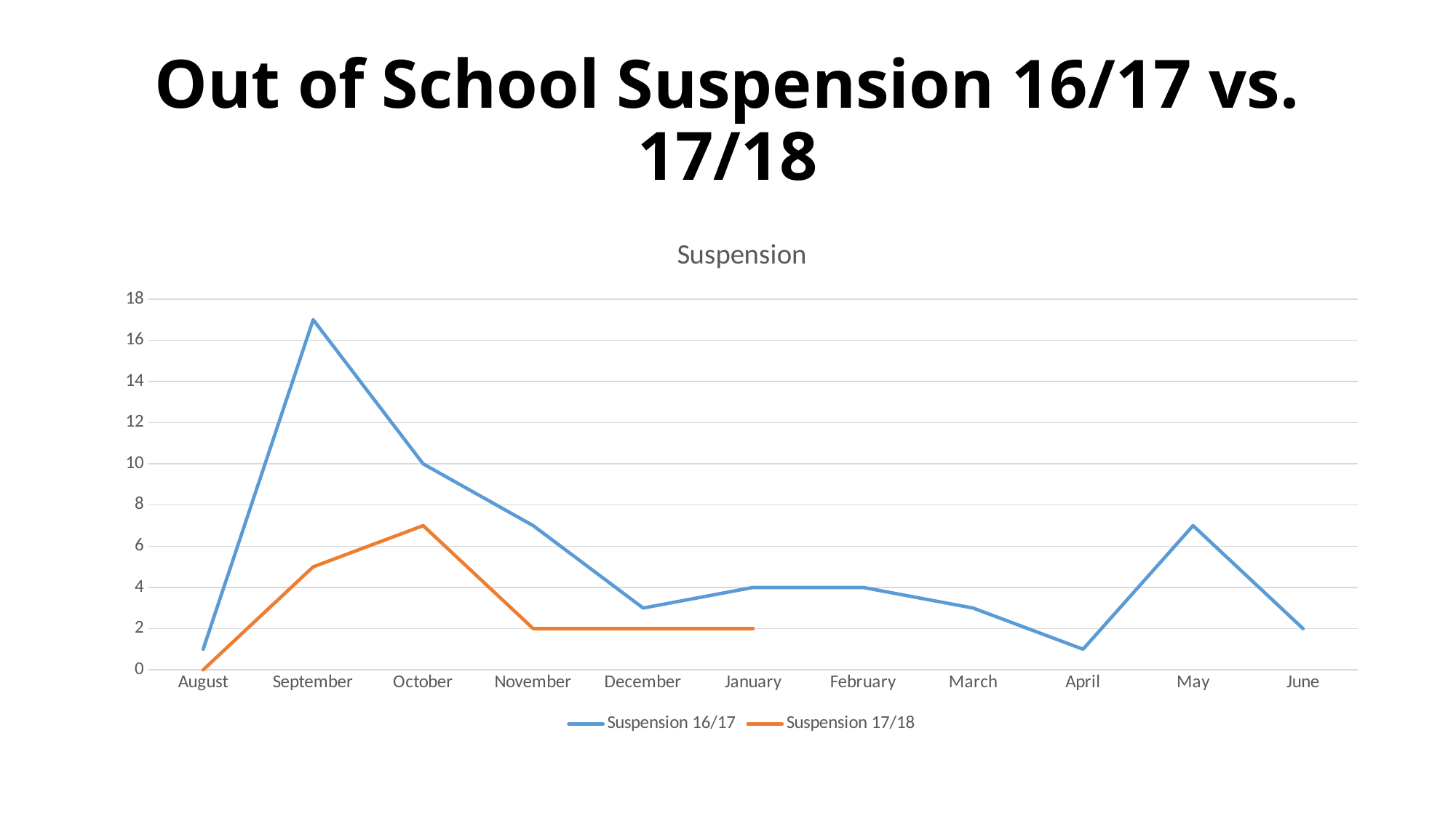
What is the value for Suspension 17/18 in August? 0 In which month is Suspension 17/18 highest? October Does Suspension 16/17 rise or fall from September to December? fall How many months are shown on the x axis? 11 Which is larger in October, Suspension 16/17 or Suspension 17/18? Suspension 16/17 How many series does the legend list? 2 What is the value for Suspension 17/18 in December? 2 What is the value for Suspension 16/17 in October? 10 Is the value for Suspension 16/17 in September greater or less than 16? greater In which month is Suspension 16/17 highest? September What is the value for Suspension 16/17 in January? 4 What kind of chart is shown on the slide? line chart